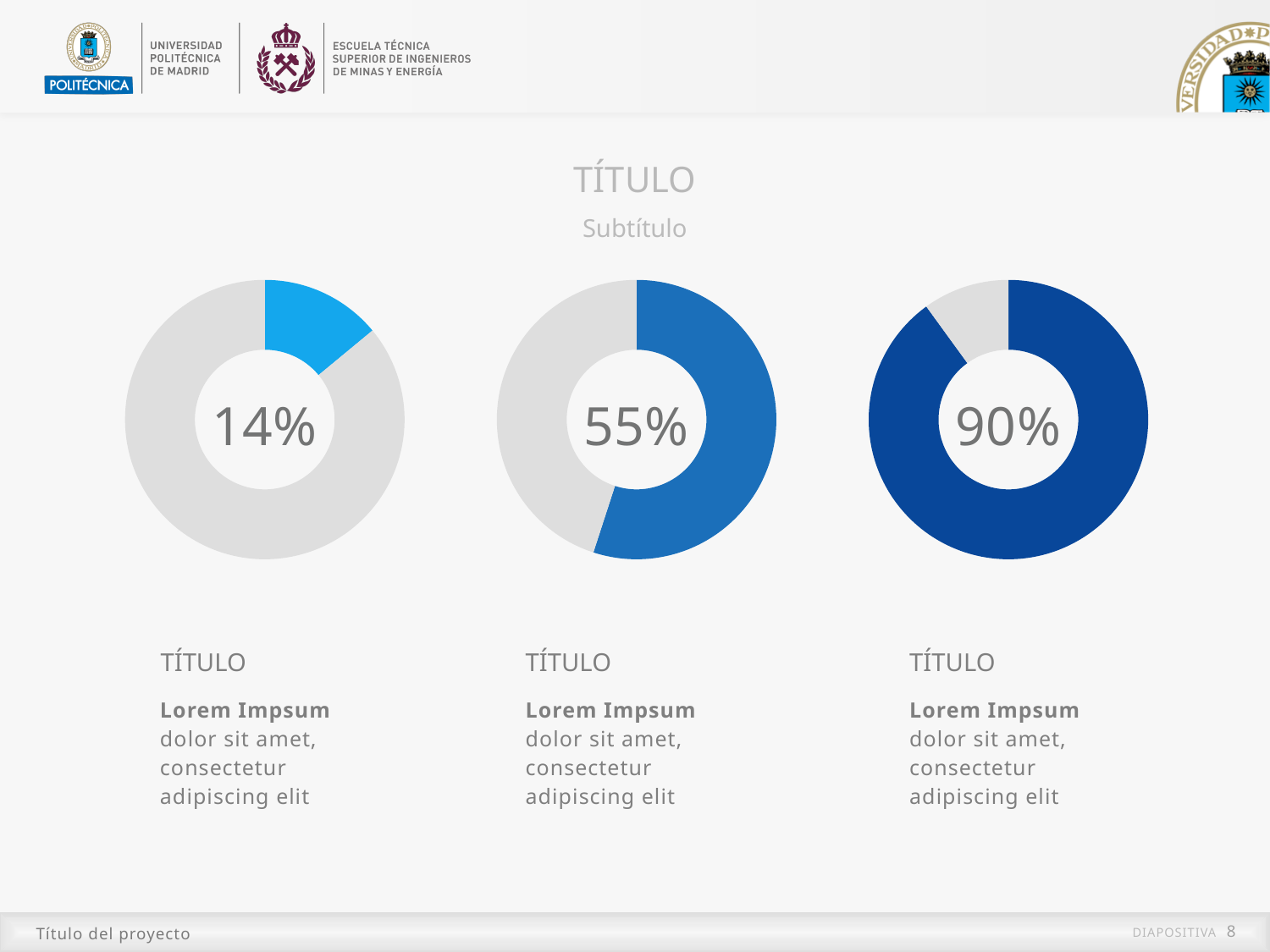
Which shows a larger percentage, the middle donut chart or the left donut chart? The middle donut chart What kind of chart is used three times on this slide? Donut chart What colour is the filled segment of the left donut chart? Light blue What percentage is shown in the centre of the middle donut chart? 55% What percentage is shown in the centre of the left donut chart? 14% What percentage is shown in the centre of the right donut chart? 90% What is the difference between the percentage in the right donut chart and the percentage in the left donut chart? 76% How many donut charts are on the slide? 3 Which of the three donut charts shows the highest percentage? The right one (90%) Which of the three donut charts shows the lowest percentage? The left one (14%) What is the difference between the percentage in the middle donut chart and the percentage in the left donut chart? 41% What is the difference between the percentage in the right donut chart and the percentage in the middle donut chart? 35%